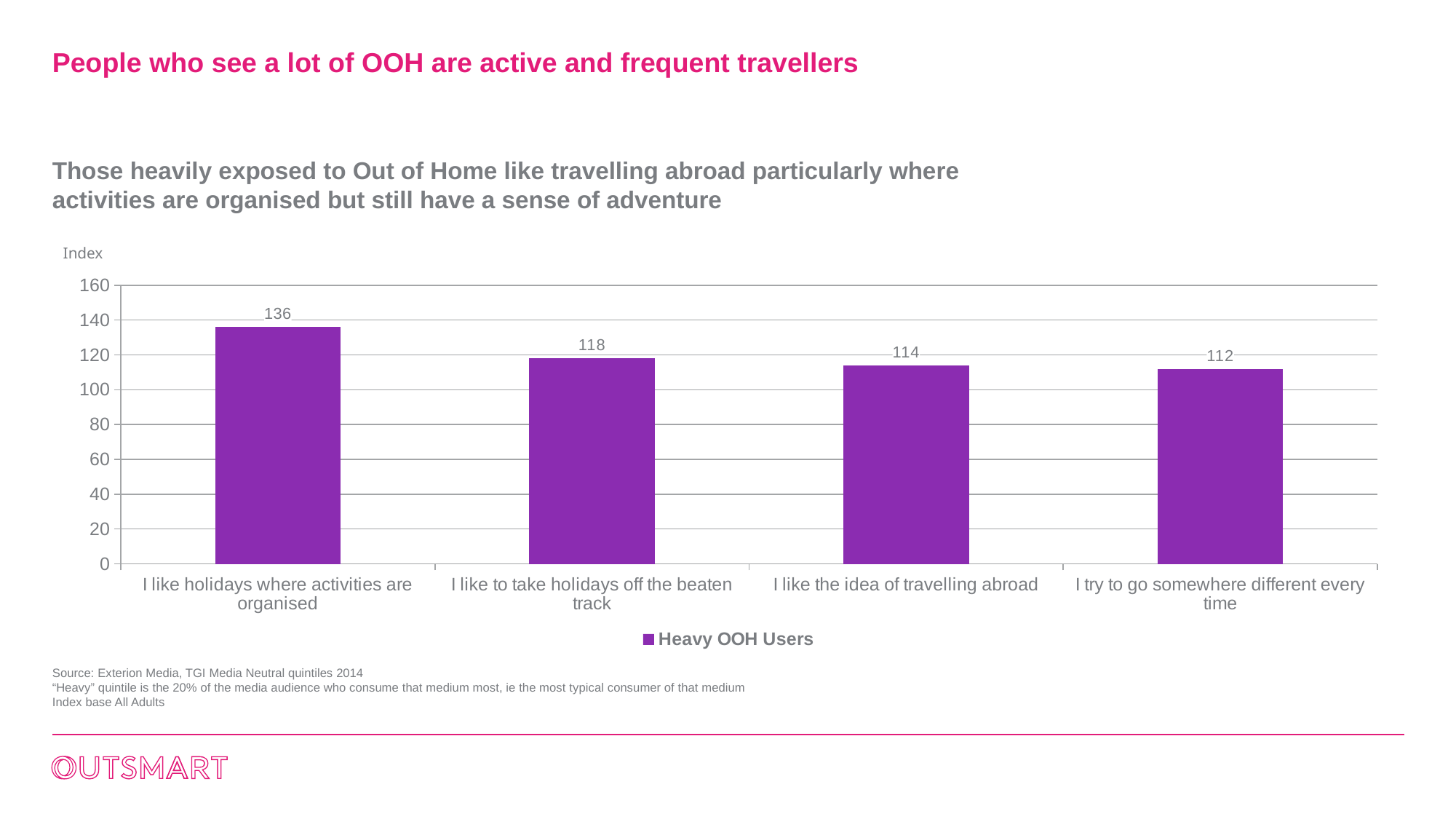
Which is larger, the index for "I like to take holidays off the beaten track" or for "I try to go somewhere different every time"? I like to take holidays off the beaten track What series does the legend list? Heavy OOH Users Is the value for "I like the idea of travelling abroad" greater or less than 100? greater What is the difference between the index for "I like holidays where activities are organised" and "I like to take holidays off the beaten track"? 18 Which category has the highest index value? I like holidays where activities are organised What is the index value for "I like holidays where activities are organised"? 136 What is the index value for "I like the idea of travelling abroad"? 114 What is the index value for "I like to take holidays off the beaten track"? 118 What is the index value for "I try to go somewhere different every time"? 112 How many categories are shown on the chart? 4 What type of chart is shown on the slide? Bar chart Which category has the lowest index value? I try to go somewhere different every time